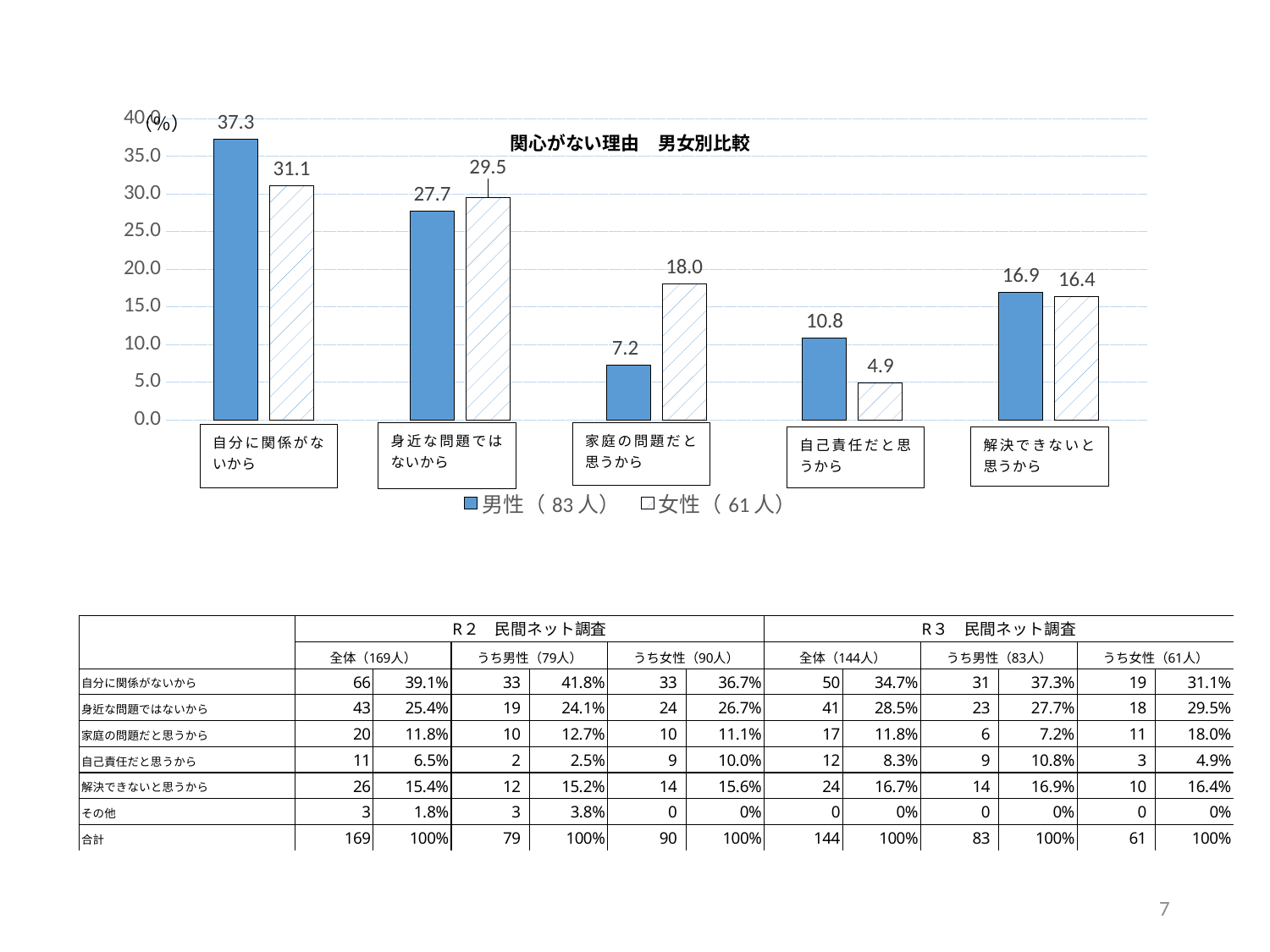
What kind of chart is shown on the slide? bar chart What is the difference between the 男性 and 女性 values in the category 家庭の問題だと思うから? 10.8 Which category has the lowest value for 女性? 自己責任だと思うから In the category 身近な問題ではないから, which is larger, the 男性 value or the 女性 value? 女性 What is the value for 女性 in the category 自己責任だと思うから? 4.9 How many series does the chart legend list? 2 What is the title of the chart? 関心がない理由 男女別比較 Is the value for 男性 in the category 解決できないと思うから greater or less than 15.0? greater What is the value for 女性 in the category 家庭の問題だと思うから? 18.0 Which category has the highest value for 男性? 自分に関係がないから What is the value for 男性 in the category 自分に関係がないから? 37.3 How many categories are shown on the x axis of the chart? 5